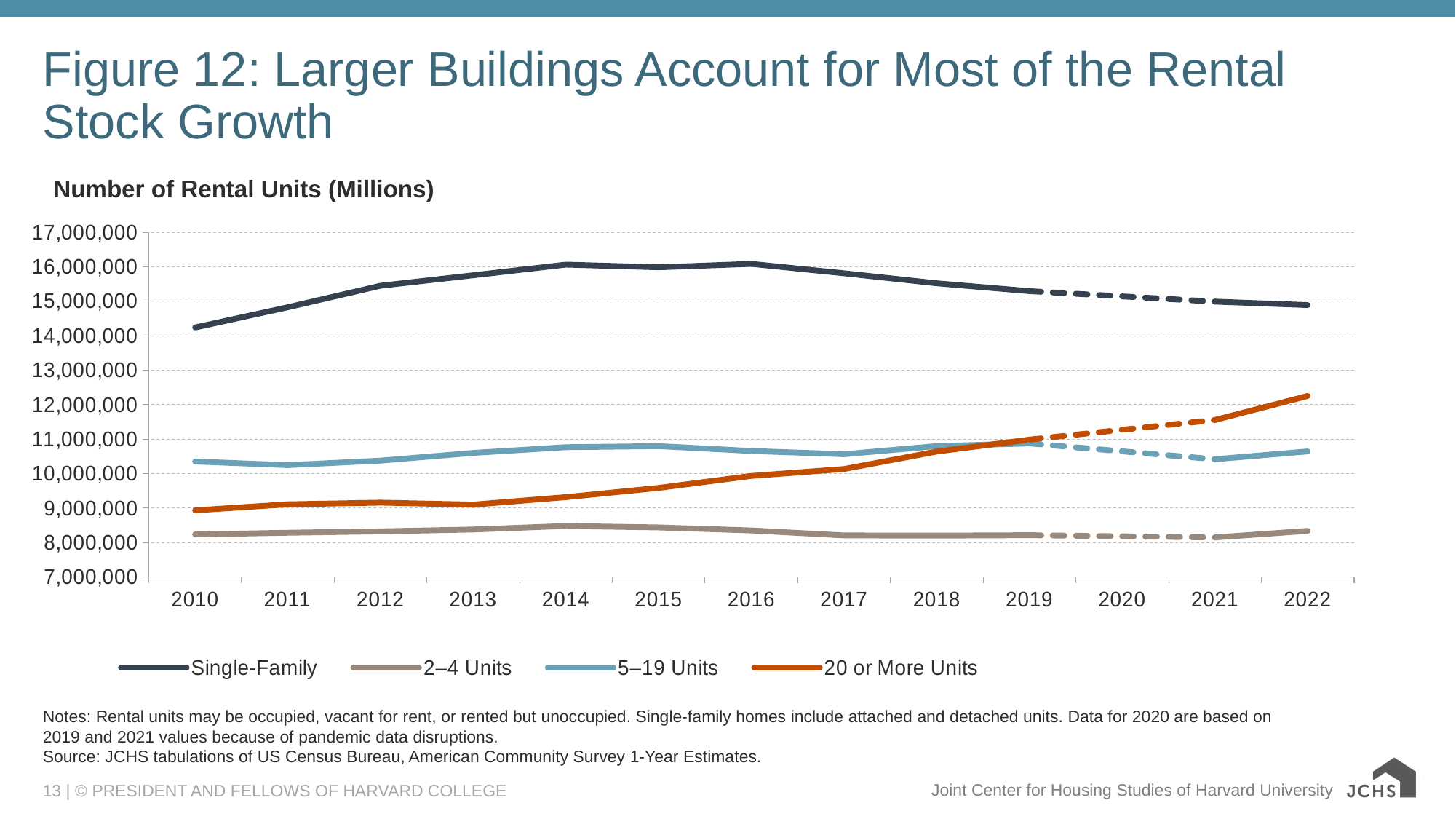
Is the value for 20 or More Units in 2022 greater or less than 12,000,000? greater How many series does the legend list? 4 Which series has the highest value in 2022? Single-Family In 2022, which is larger: 20 or More Units or 5–19 Units? 20 or More Units In 2010, which is larger: 5–19 Units or 20 or More Units? 5–19 Units Which series has the lowest value in 2010? 2–4 Units Is the value for 2–4 Units in 2014 greater or less than 9,000,000? less What kind of chart is shown on the slide? line chart In which year does the 20 or More Units series reach its highest value? 2022 How many years are shown on the x axis? 13 Does the 20 or More Units series rise or fall from 2010 to 2022? rise Is the value for Single-Family in 2010 greater or less than 15,000,000? less